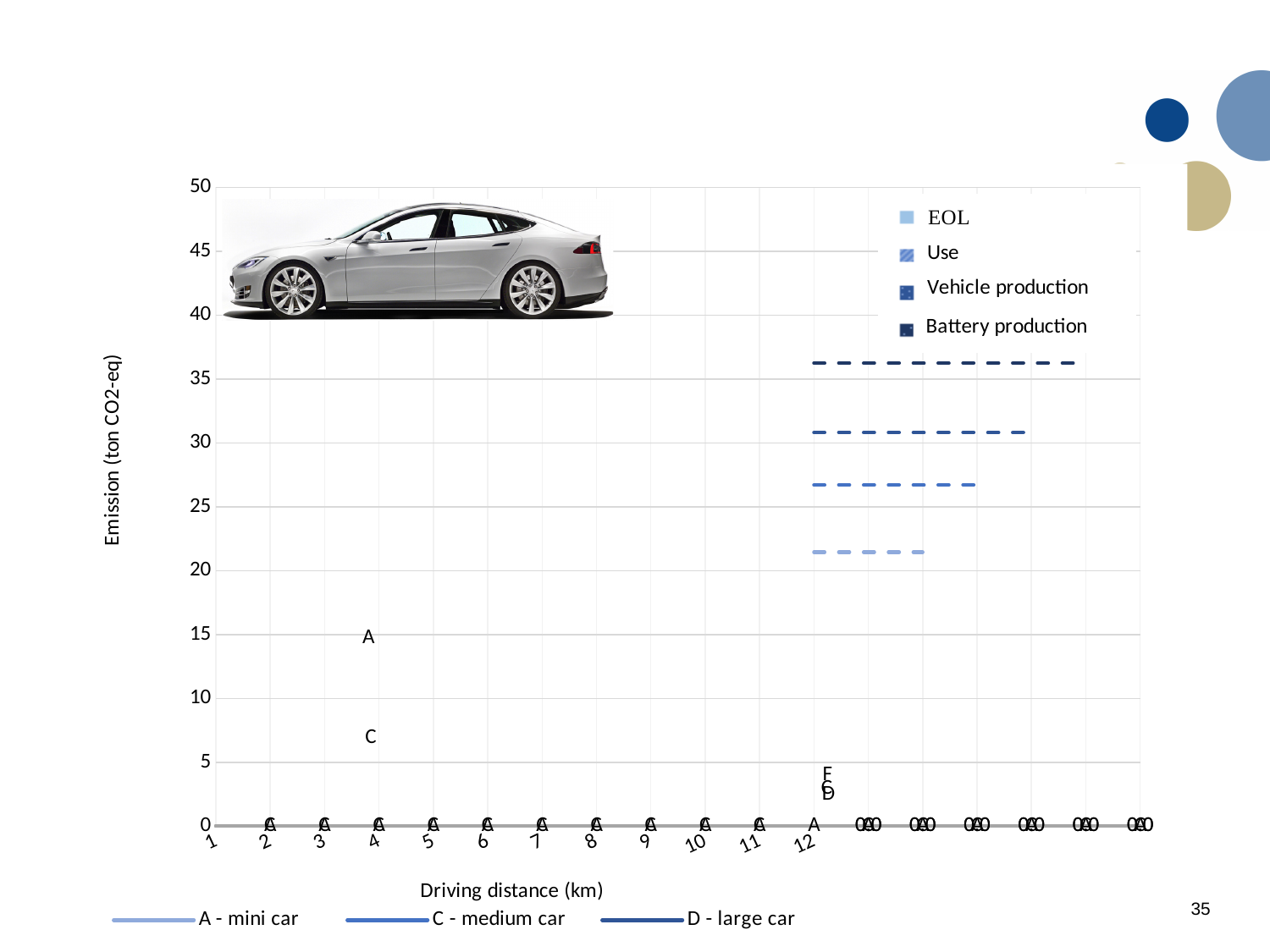
What is the title of the x axis of the chart? Driving distance (km) Which car type does the legend entry 'A' correspond to? mini car Is the value of the topmost dashed line greater or less than 35? greater Which car type does the legend entry 'D' correspond to? large car How many entries does the legend in the upper right of the chart list? 4 Is the value of the lowest dashed line greater or less than 20? greater What is the title of the y axis of the chart? Emission (ton CO2-eq) Which dashed line is higher on the chart: the darkest blue one or the lightest blue one? the darkest blue one Is the value of the lowest dashed line greater or less than 25? less How many car types does the legend at the bottom of the chart list? 3